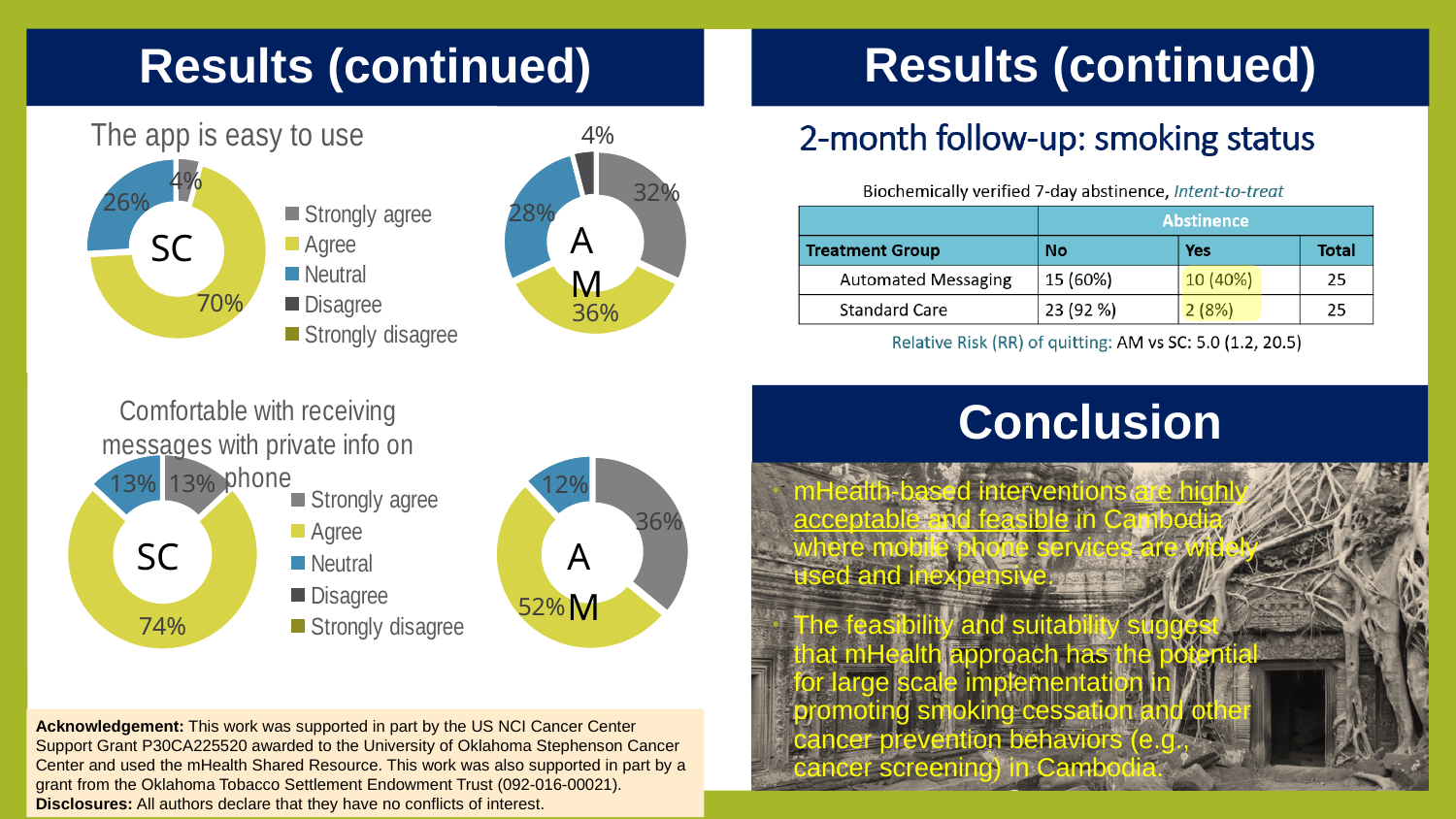
In the 'Comfortable with receiving messages with private info on phone' AM chart, what is the largest slice's value? 52% For 'Comfortable with receiving messages with private info on phone', which group has the larger top slice, SC (74%) or AM (52%)? SC In the 'The app is easy to use' AM chart, what is the smallest slice's value? 4% In the 'The app is easy to use' AM chart, what is the largest slice's value? 36% In the 'The app is easy to use' SC chart, what is the largest slice's value? 70% How many entries does the legend list for the 'The app is easy to use' charts? 5 In the 'The app is easy to use' SC chart, what is the difference in percentage points between the 70% slice and the 26% slice? 44 What kind of chart is used for 'The app is easy to use' SC results? doughnut chart How many slices are shown in the 'Comfortable with receiving messages with private info on phone' SC chart? 3 In the 'The app is easy to use' SC chart, what value is shown for the blue (Neutral) slice? 26% How many slices are shown in the 'The app is easy to use' AM chart? 4